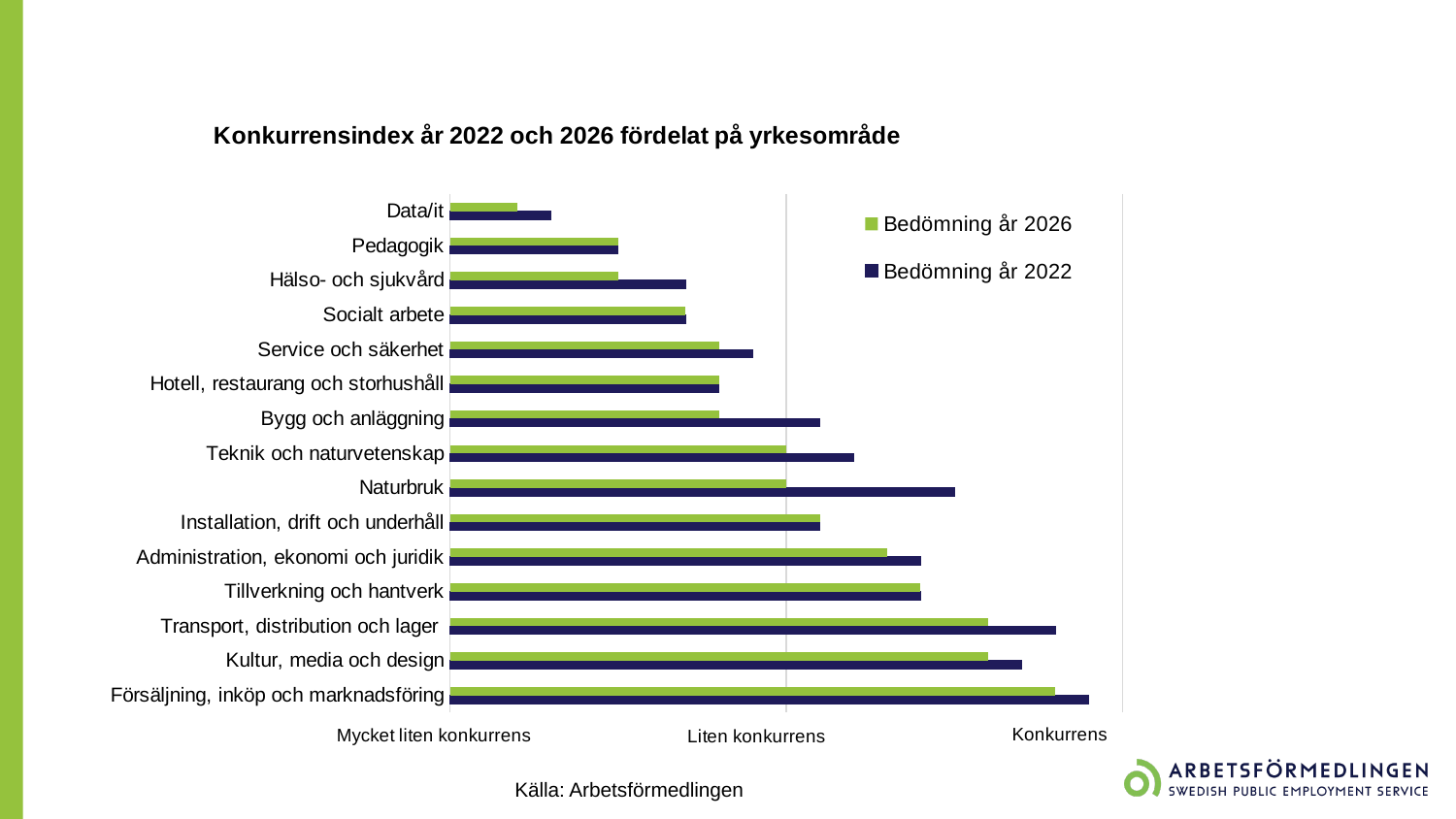
Which occupational area has the lowest value for Bedömning år 2026? Data/it What is the title of the chart? Konkurrensindex år 2022 och 2026 fördelat på yrkesområde How many series does the legend list? 2 For Naturbruk, which is larger: the value for Bedömning år 2022 or Bedömning år 2026? Bedömning år 2022 How many occupational areas (categories) are listed on the chart? 15 For Bedömning år 2022, which is larger: Transport, distribution och lager or Kultur, media och design? Transport, distribution och lager What kind of chart is shown on the slide? Bar chart Which colour represents Bedömning år 2026 in the legend? Green Which occupational area has the highest value for Bedömning år 2022? Försäljning, inköp och marknadsföring Which occupational area has the highest value for Bedömning år 2026? Försäljning, inköp och marknadsföring For Bygg och anläggning, which is larger: the value for Bedömning år 2022 or Bedömning år 2026? Bedömning år 2022 Which occupational area has the lowest value for Bedömning år 2022? Data/it